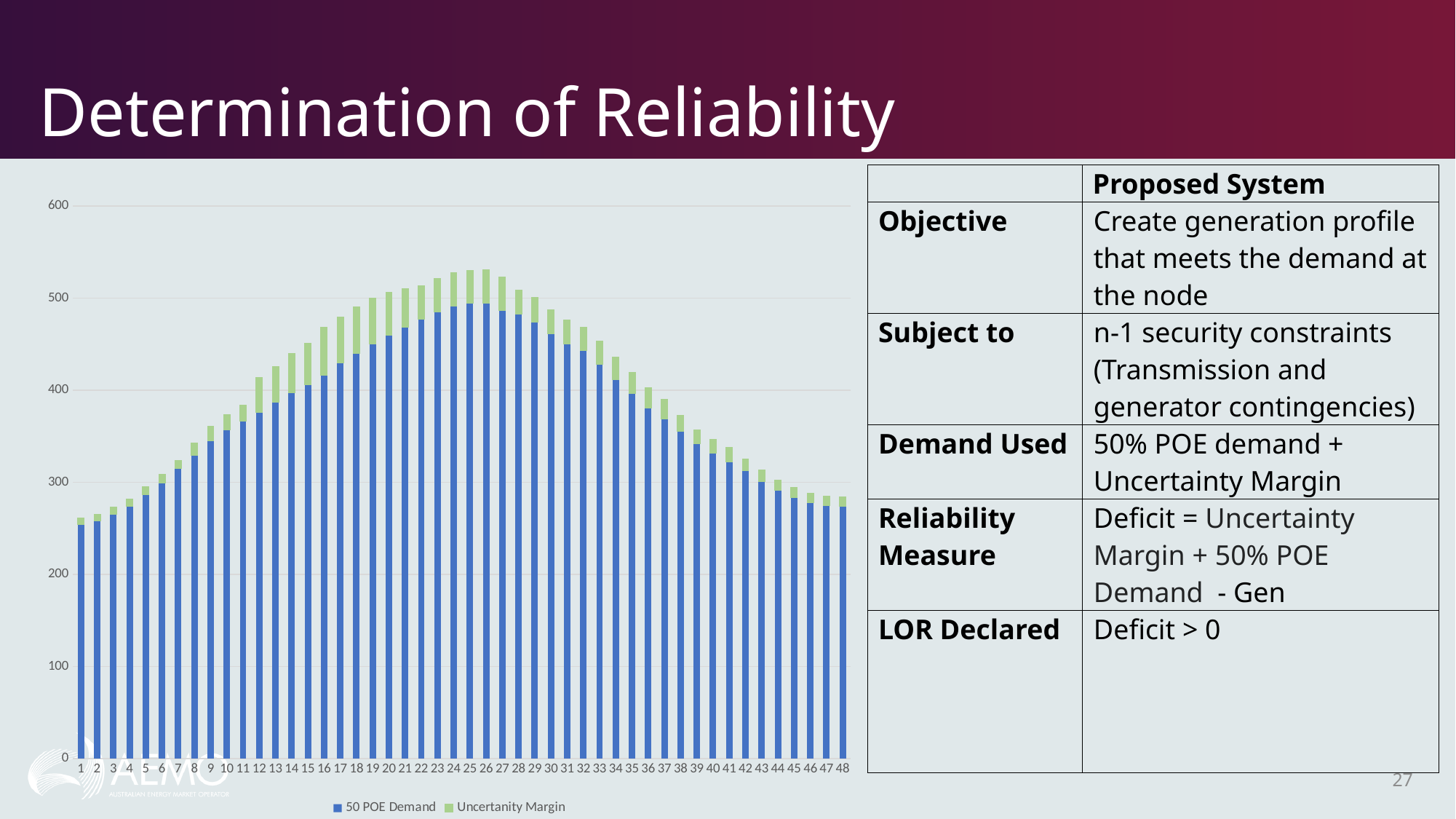
Is the 50 POE Demand value for category 25 greater or less than 400? greater Do the stacked bar values rise or fall from category 1 to category 25? Rise How many series does the chart's legend list? 2 Is the total stacked value for category 1 greater or less than 300? less How many categories are plotted along the x axis of the chart? 48 What kind of chart is shown on the slide? Stacked bar chart Do the stacked bar values rise or fall from category 27 to category 48? Fall Is the total stacked value for category 13 greater or less than 400? greater Which colour represents the 50 POE Demand series in the chart? Blue What are the two series named in the chart's legend? 50 POE Demand and Uncertanity Margin Which has a larger total stacked value, category 10 or category 40? Category 10